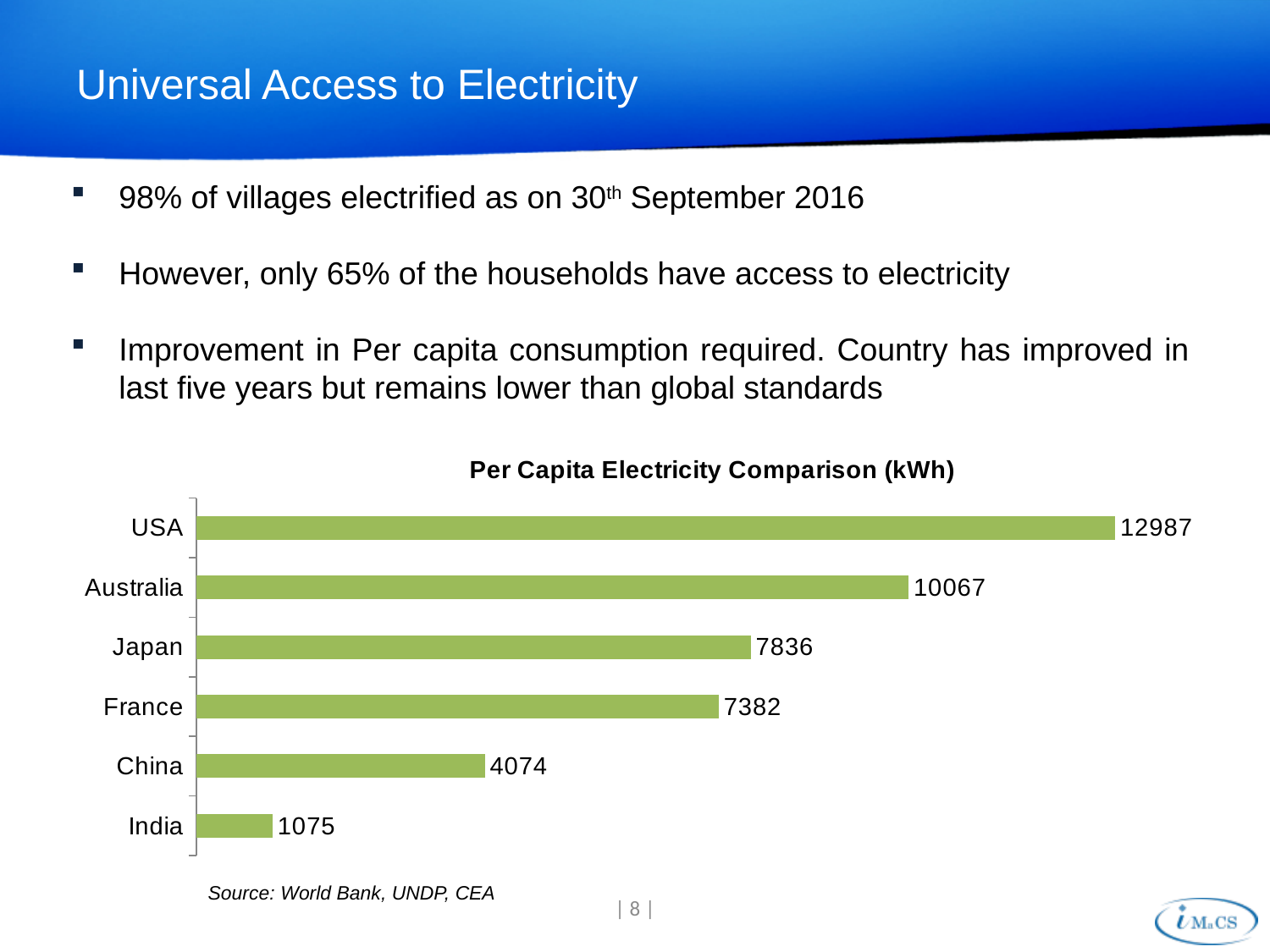
Which has a higher per capita electricity consumption, China or France? France What is the per capita electricity consumption for India? 1075 What is the difference between the values for Japan and France? 454 What kind of chart is shown on the slide? Bar chart Which country has the highest per capita electricity consumption? USA What is the per capita electricity consumption for Japan? 7836 How many countries are shown in the chart? 6 What is the value shown for Australia? 10067 What is the difference between the values for USA and India? 11912 What is the title of the chart? Per Capita Electricity Comparison (kWh) What colour are the bars in the chart? Green Which country has the lowest per capita electricity consumption? India